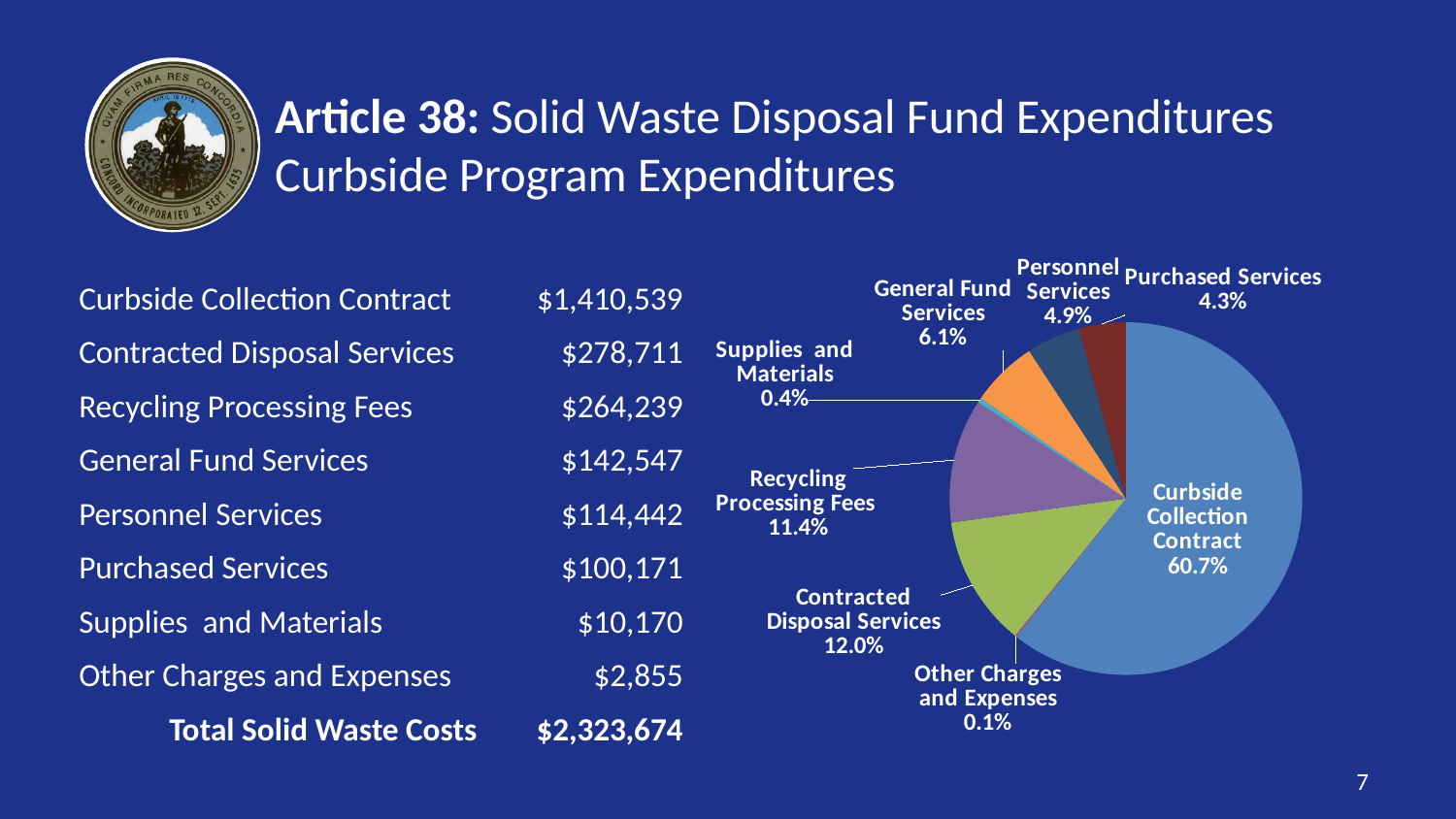
What is the difference in percentage points between Curbside Collection Contract and Contracted Disposal Services in the pie chart? 48.7% What percentage is shown for Contracted Disposal Services in the pie chart? 12.0% What type of chart is shown on the slide? pie chart How many slices does the pie chart have? 8 What percentage is shown for Supplies and Materials in the pie chart? 0.4% Which slice of the pie chart is the largest? Curbside Collection Contract What is the difference in percentage points between General Fund Services and Personnel Services in the pie chart? 1.2% Which slice of the pie chart is the smallest? Other Charges and Expenses What percentage is shown for Recycling Processing Fees in the pie chart? 11.4% What percentage is shown for Personnel Services in the pie chart? 4.9% Which is larger in the pie chart, General Fund Services or Purchased Services? General Fund Services What share of the pie does Curbside Collection Contract represent? 60.7%